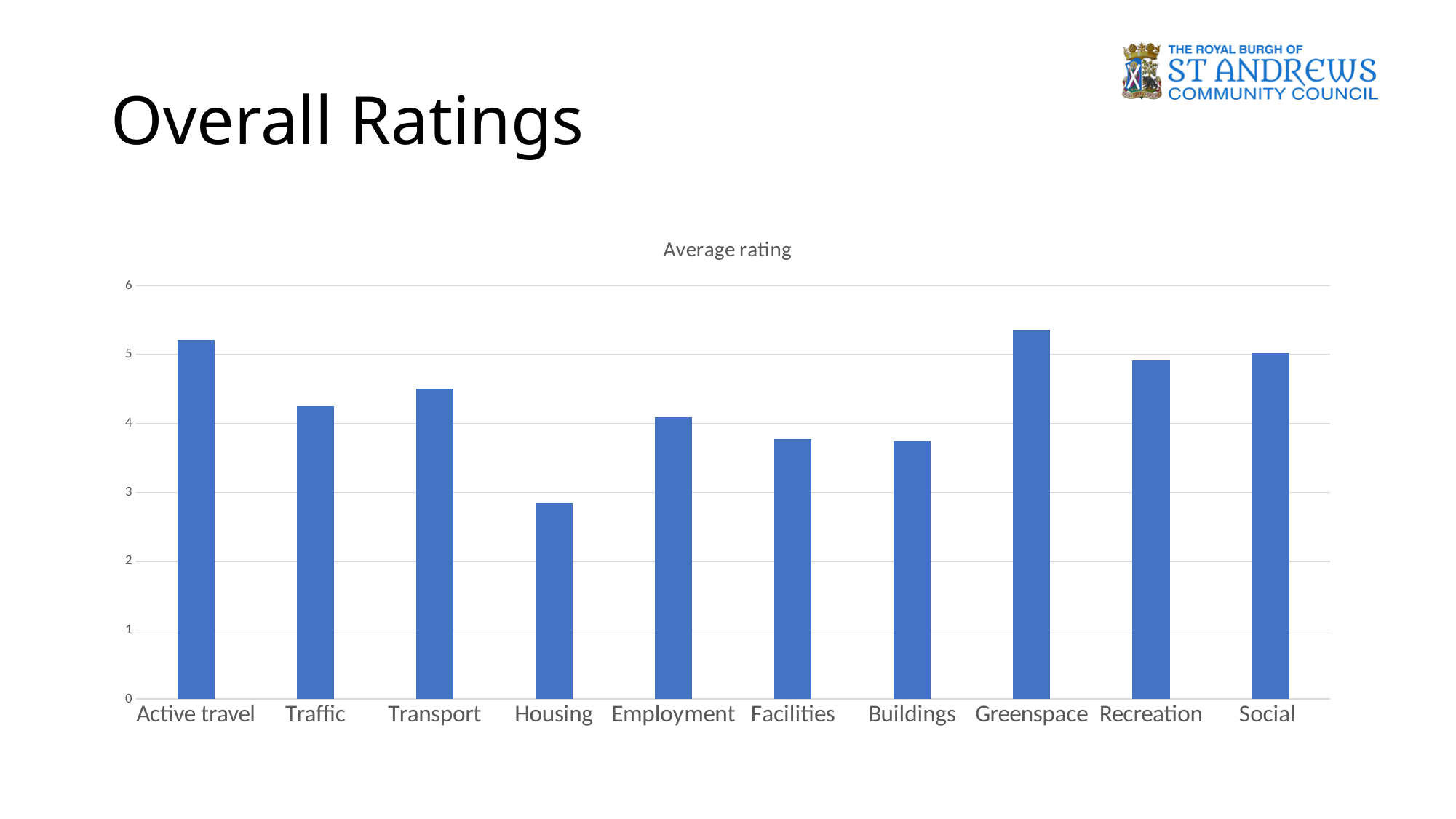
Is the value for Traffic greater or less than 4? greater Is the value for Buildings greater or less than 4? less What colour are the bars in the chart? Blue Which category has the lowest average rating? Housing How many categories are shown on the x axis of the chart? 10 What is the title of the chart? Average rating Which has a higher average rating, Housing or Facilities? Facilities Which has a higher average rating, Transport or Traffic? Transport Is the value for Greenspace greater or less than 5? greater Which category has the highest average rating? Greenspace What kind of chart is shown on the slide? Bar chart